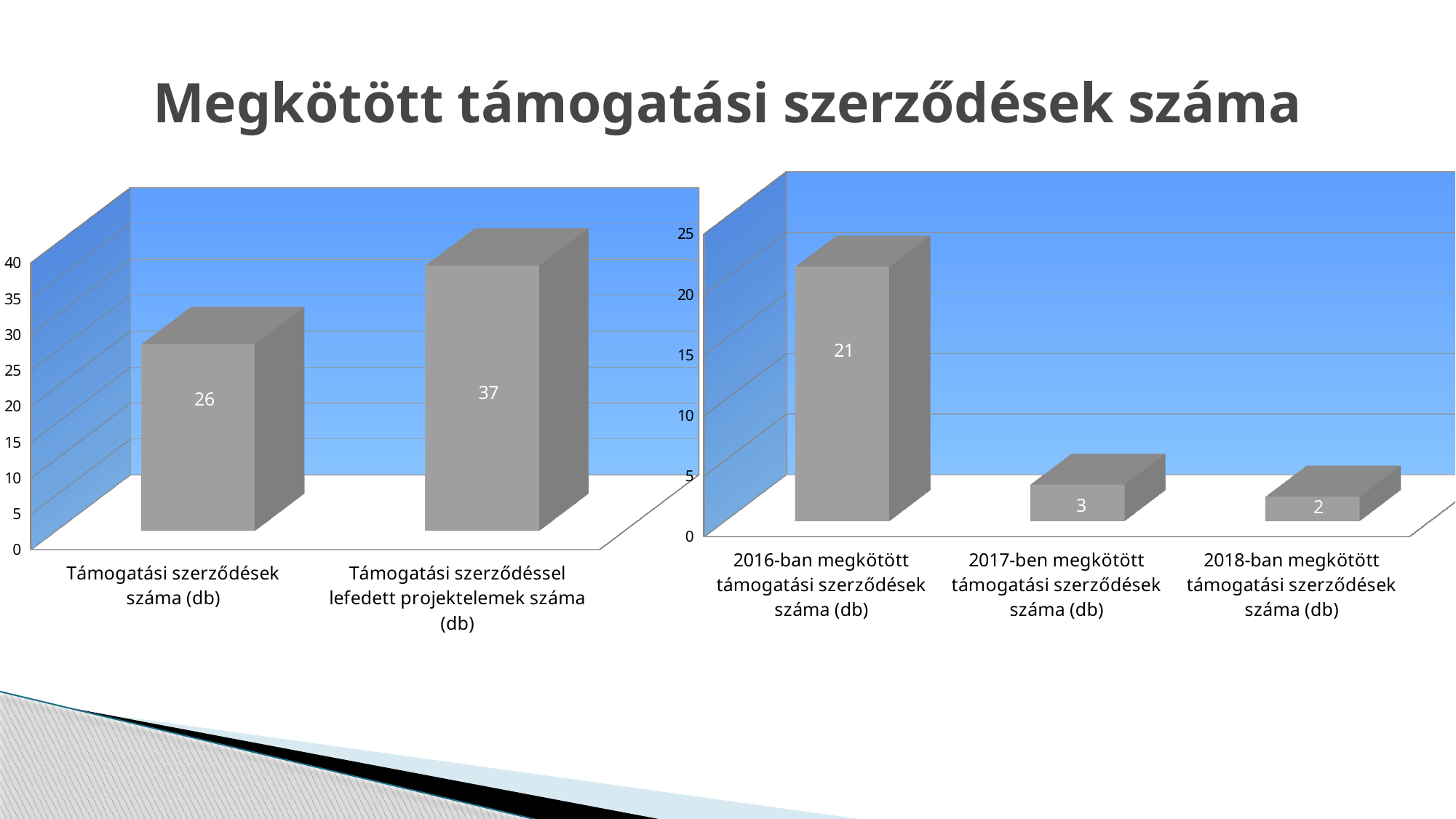
In the left chart, what is the value for "Támogatási szerződések száma (db)"? 26 In the left chart, what is the value for "Támogatási szerződéssel lefedett projektelemek száma (db)"? 37 In the right chart, do the values rise or fall from 2016 to 2018? fall In the right chart, what is the difference between the 2016 and 2017 values? 18 In the right chart, what is the value for "2017-ben megkötött támogatási szerződések száma (db)"? 3 In the right chart, which category has the lowest value? 2018-ban megkötött támogatási szerződések száma (db) What type of chart is the right chart? bar chart In the right chart, what is the value for "2018-ban megkötött támogatási szerződések száma (db)"? 2 In the left chart, what is the difference between the two bars? 11 In the right chart, what is the value for "2016-ban megkötött támogatási szerződések száma (db)"? 21 How many bars are shown in the left chart? 2 In the left chart, which category has the higher value? Támogatási szerződéssel lefedett projektelemek száma (db)